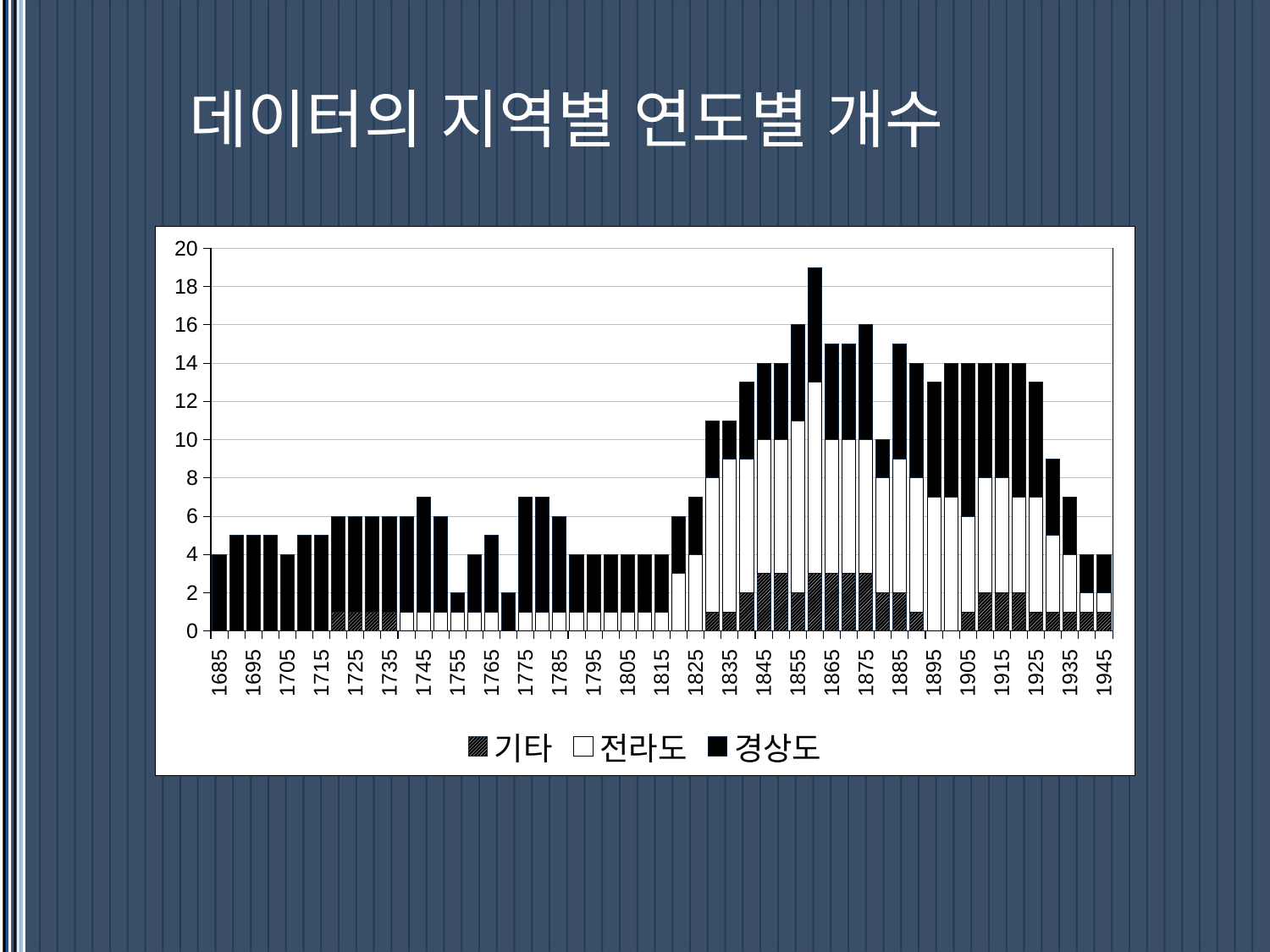
Is the total of the tallest bar in the chart greater or less than 18? greater What is the title of the slide containing the chart? 데이터의 지역별 연도별 개수 What is the total height of the stacked bar for 1685? 4 How many series does the legend list? 3 Is the total for 1935 greater or less than 8? less Do the bar totals generally rise or fall from 1815 to 1855? rise Which year has the larger total, 1855 or 1685? 1855 What are the three series named in the legend? 기타, 전라도, 경상도 What kind of chart is shown on the slide? Stacked bar chart What is the total height of the stacked bar for 1855? 16 Is the total for 1835 greater or less than 10? greater What is the total height of the stacked bar for 1845? 14